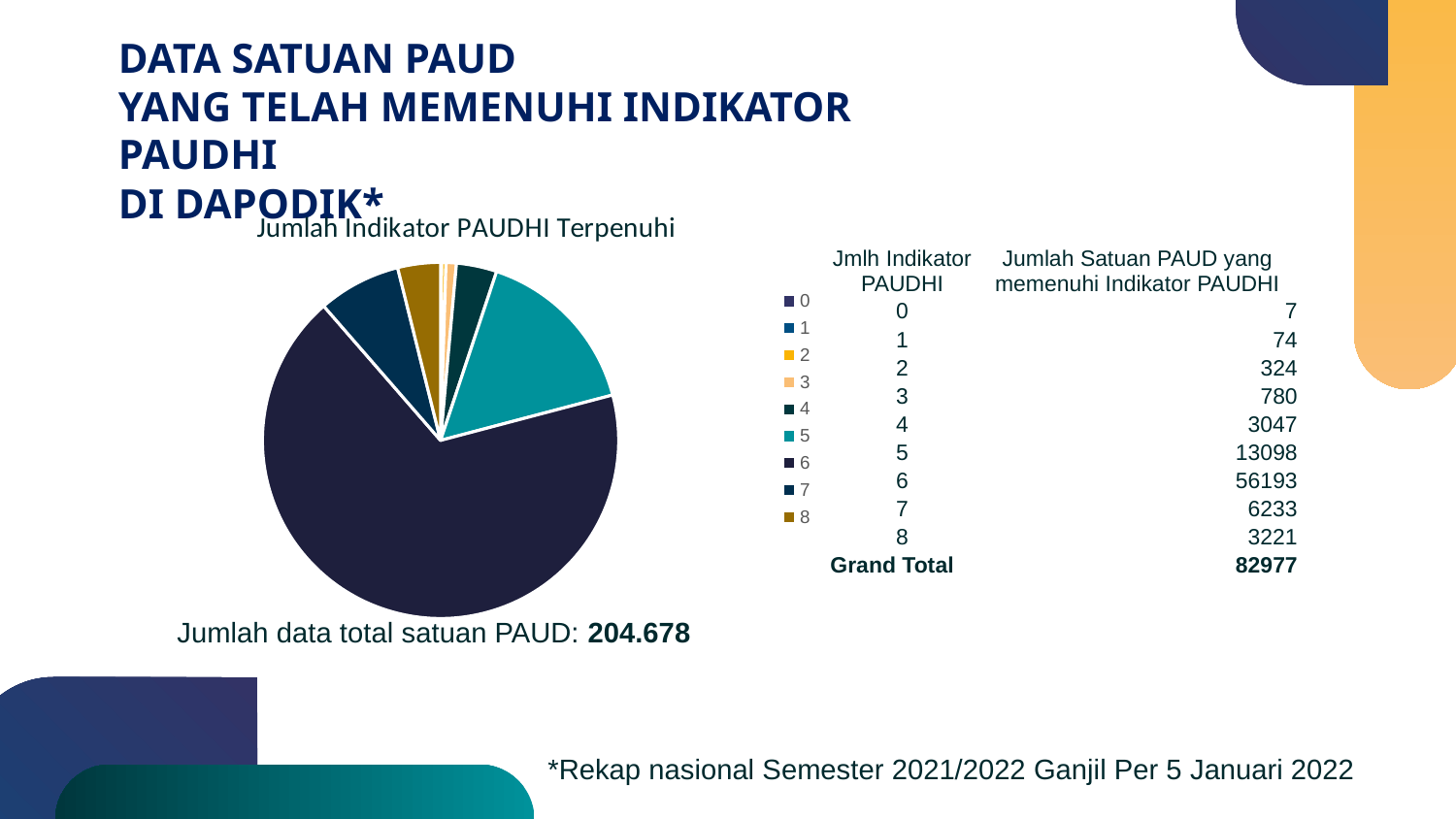
How many categories does the pie chart's legend list? 9 Which number of indicators (category) has the largest slice of the pie chart? 6 What is the total number of satuan PAUD data stated below the pie chart? 204.678 According to the table, how many satuan PAUD have met 4 PAUDHI indicators? 3047 What is the difference between the number of satuan PAUD meeting 6 indicators and those meeting 5 indicators? 43095 What kind of chart is shown on the slide? pie chart According to the table, how many satuan PAUD have met 6 PAUDHI indicators? 56193 According to the table, how many satuan PAUD have met 0 PAUDHI indicators? 7 Which number of indicators (category) has the smallest value in the table? 0 What is the Grand Total of satuan PAUD in the table? 82977 What is the title of the pie chart? Jumlah Indikator PAUDHI Terpenuhi Which is larger: the number of satuan PAUD meeting 7 indicators or those meeting 8 indicators? 7 indicators